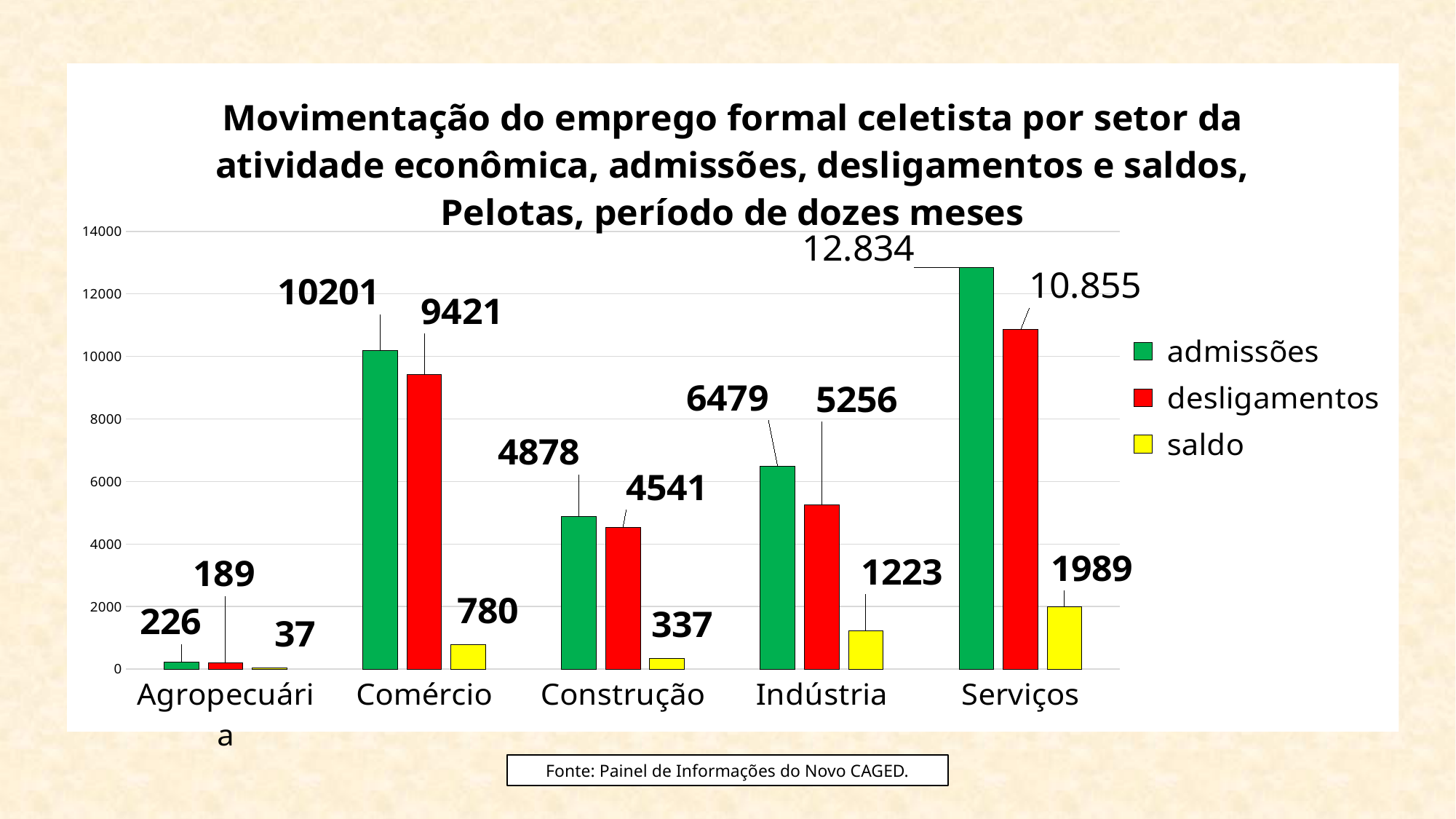
Which is larger, the admissões for Construção or the admissões for Indústria? Indústria Which sector has the lowest saldo? Agropecuária What colour are the saldo bars? yellow What type of chart is shown on the slide? bar chart What is the value of admissões for Comércio? 10201 Is the value of desligamentos for Comércio greater or less than 8000? greater How many sectors (categories) are shown on the x axis? 5 What is the saldo for Indústria? 1223 Which sector has the highest value of admissões? Serviços What is the value of desligamentos for Serviços? 10.855 How many series does the legend list? 3 What is the difference between admissões and desligamentos for Indústria? 1223